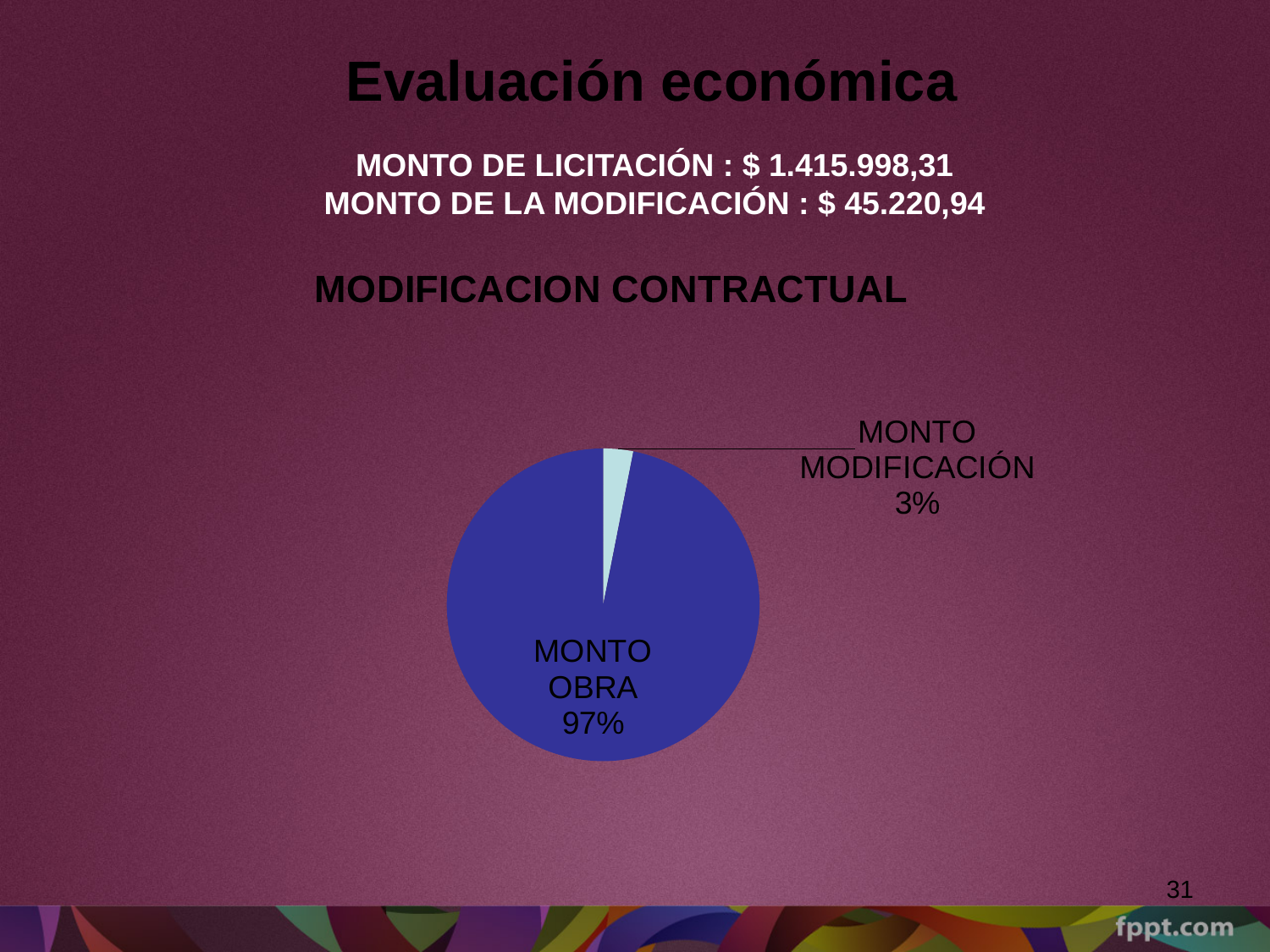
What is the difference in percentage points between the MONTO OBRA slice and the MONTO MODIFICACIÓN slice? 94 percentage points What is the title of the pie chart? MODIFICACION CONTRACTUAL What colour is the MONTO OBRA slice of the pie chart? blue How many slices does the pie chart have? 2 Which slice of the pie chart is the largest? MONTO OBRA What share of the pie does MONTO OBRA represent? 97% What kind of chart is shown on the slide? pie chart Which slice of the pie chart is the smallest? MONTO MODIFICACIÓN What share of the pie does MONTO MODIFICACIÓN represent? 3% Which is larger, the MONTO OBRA slice or the MONTO MODIFICACIÓN slice? MONTO OBRA